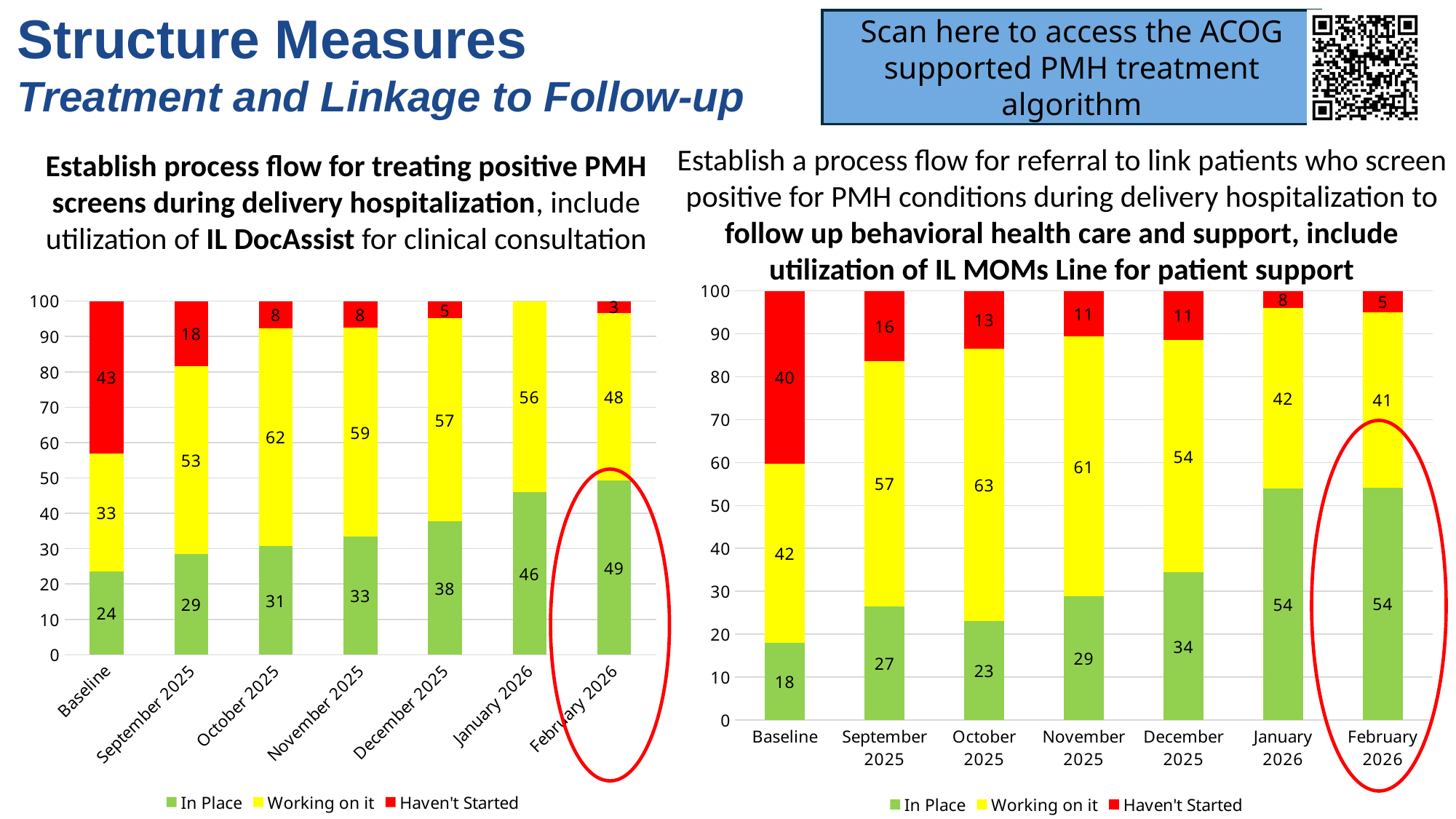
In the left chart, which category has the highest 'In Place' value? February 2026 How many categories are shown on the x axis of the right chart? 7 In the left chart, what is the 'Haven't Started' value for Baseline? 43 In the right chart, which is larger: the 'Haven't Started' value for September 2025 or for February 2026? September 2025 In the left chart, what is the difference between the 'In Place' values for February 2026 and Baseline? 25 What type of chart is the left chart? Stacked bar chart In the right chart, does the 'In Place' value generally rise or fall from Baseline to February 2026? Rise In the right chart, what is the 'Working on it' value for October 2025? 63 In the left chart, what is the 'In Place' value for February 2026? 49 In the right chart, what is the 'In Place' value for Baseline? 18 How many series does the legend of the left chart list? 3 In the right chart, which category has the lowest 'In Place' value? Baseline